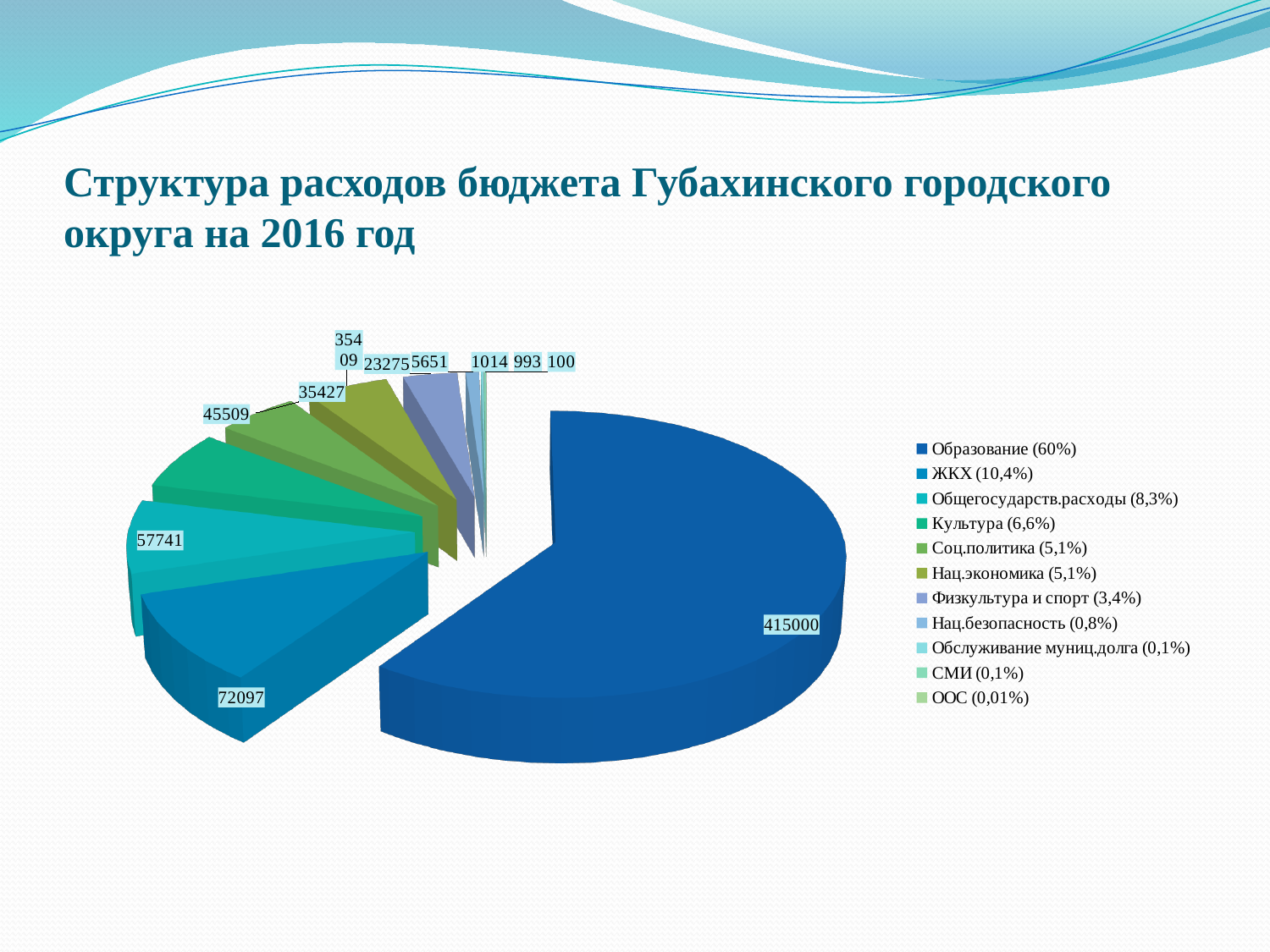
What kind of chart is shown on the slide? pie chart What is the value shown for ЖКХ? 72097 What is the value shown for Культура? 45509 Which is larger, the value for Культура or the value for Соц.политика? Культура What is the difference between the values for ЖКХ and Общегосударств.расходы? 14356 Which category has the smallest slice of the pie? ООС How many categories does the legend list? 11 What is the value shown for Общегосударств.расходы? 57741 What is the title of the slide? Структура расходов бюджета Губахинского городского округа на 2016 год Which category has the largest slice of the pie? Образование What is the value shown for Образование? 415000 What share of the pie does Физкультура и спорт represent? 3,4%